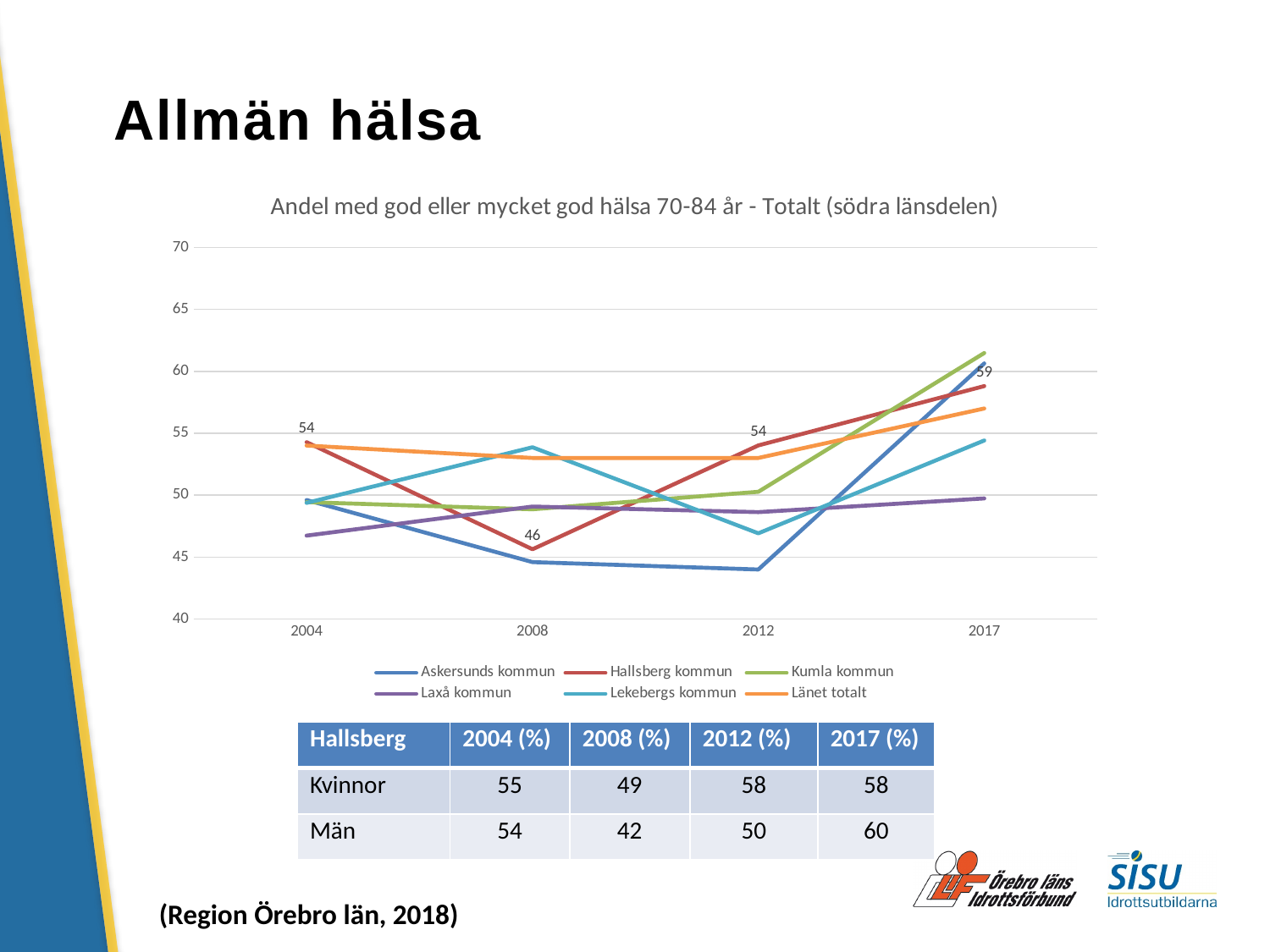
What kind of chart is shown on the slide? line chart What is the title of the chart? Andel med god eller mycket god hälsa 70-84 år - Totalt (södra länsdelen) Which series has the lowest value in 2004? Laxå kommun Is the value for Kumla kommun in 2017 greater or less than 60? greater How many years are shown on the x axis of the chart? 4 What is the value for Hallsberg kommun in 2008? 46 How many series does the chart legend list? 6 By how much did the value for Hallsberg kommun increase from 2008 to 2017? 13 What is the value for Hallsberg kommun in 2004? 54 Which series has the lowest value in 2012? Askersunds kommun Which is larger for Hallsberg kommun: the value in 2004 or the value in 2008? 2004 What is the value for Hallsberg kommun in 2017? 59